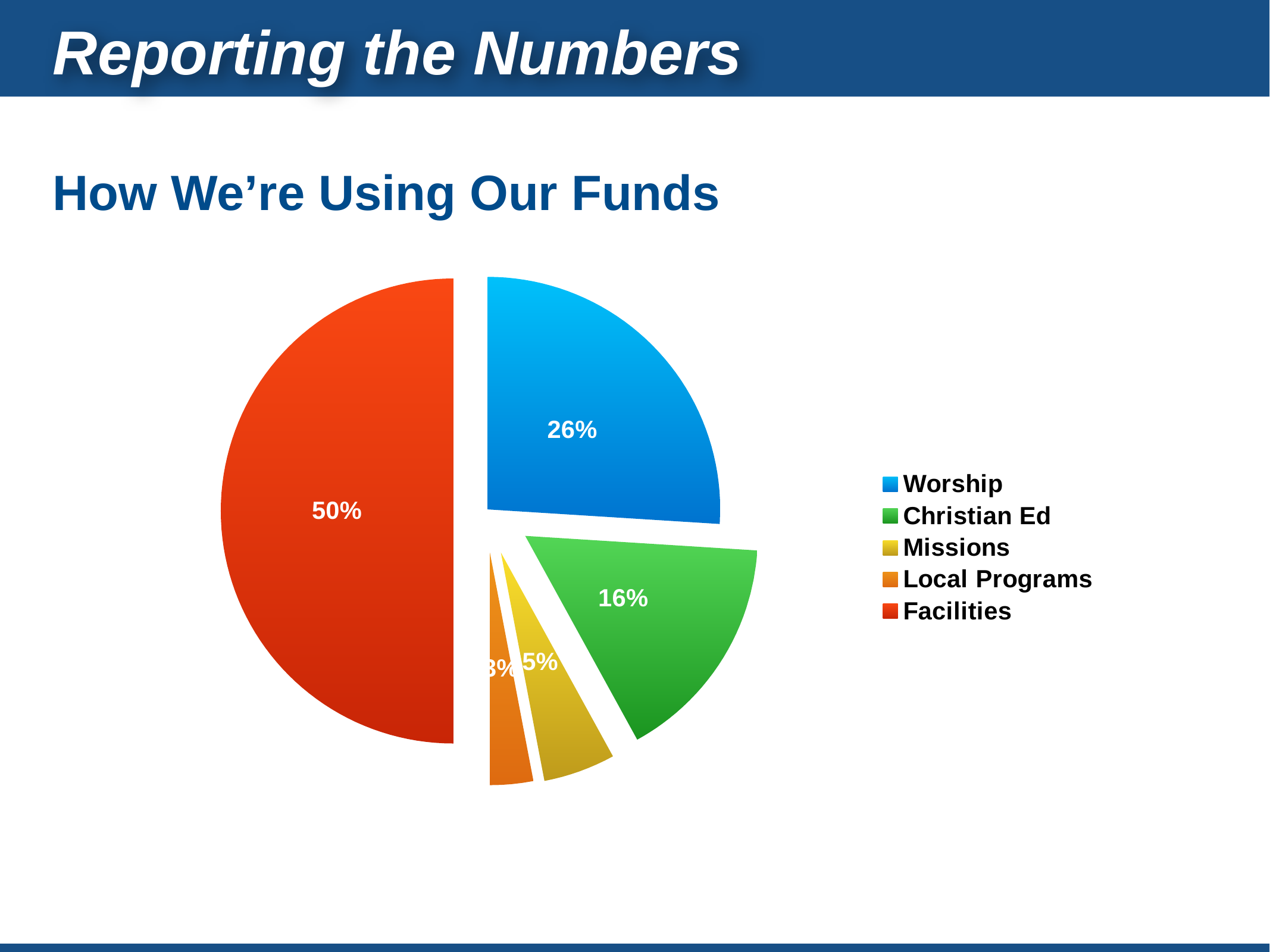
How many entries does the legend list? 5 What kind of chart is shown on the slide? Pie chart What percentage of funds goes to Worship? 26% What percentage of funds goes to Facilities? 50% What percentage of funds goes to Christian Ed? 16% Which category receives the smallest share of funds? Local Programs What percentage of funds goes to Missions? 5% What colour is the Facilities slice in the pie chart? Red How many percentage points larger is the Facilities share than the Worship share? 24 Which receives a larger share of funds, Worship or Christian Ed? Worship How many categories does the pie chart show? 5 Which category receives the largest share of funds? Facilities